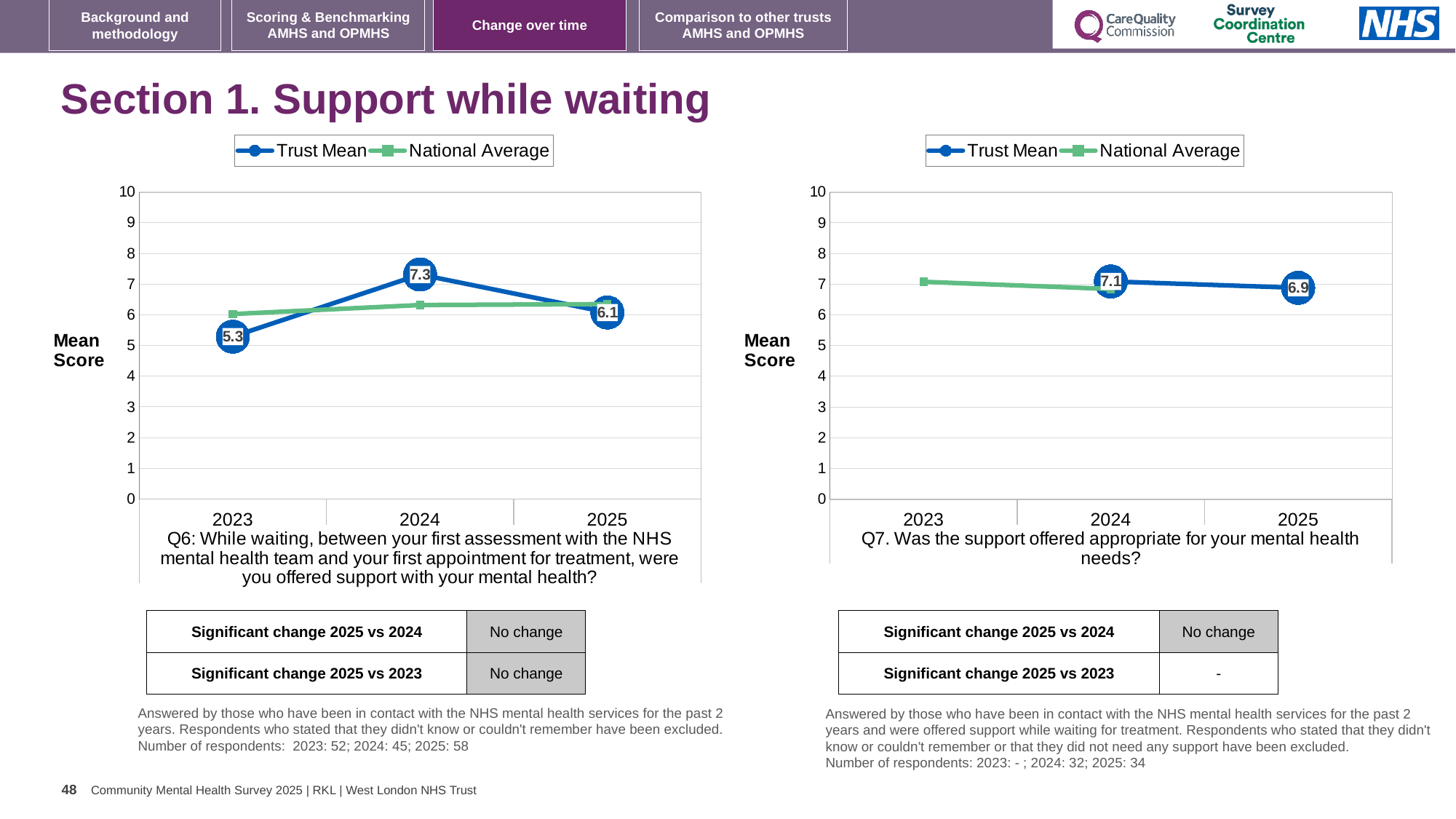
How many years are shown on the x axis of the right chart (Q7)? 3 What kind of chart is the left chart (Q6)? Line chart On the left chart (Q6), what is the difference between the Trust Mean scores for 2024 and 2023? 2.0 On the left chart (Q6), what is the Trust Mean score for 2024? 7.3 On the right chart (Q7), what is the Trust Mean score for 2025? 6.9 On the right chart (Q7), does the Trust Mean rise or fall from 2024 to 2025? Fall How many series does the legend of the left chart (Q6) list? 2 On the left chart (Q6), which year has the highest Trust Mean score? 2024 On the right chart (Q7), which is larger, the Trust Mean for 2024 or for 2025? 2024 On the left chart (Q6), what is the Trust Mean score for 2023? 5.3 On the left chart (Q6), is the National Average value for 2023 greater or less than 7? less On the left chart (Q6), which year has the lowest Trust Mean score? 2023